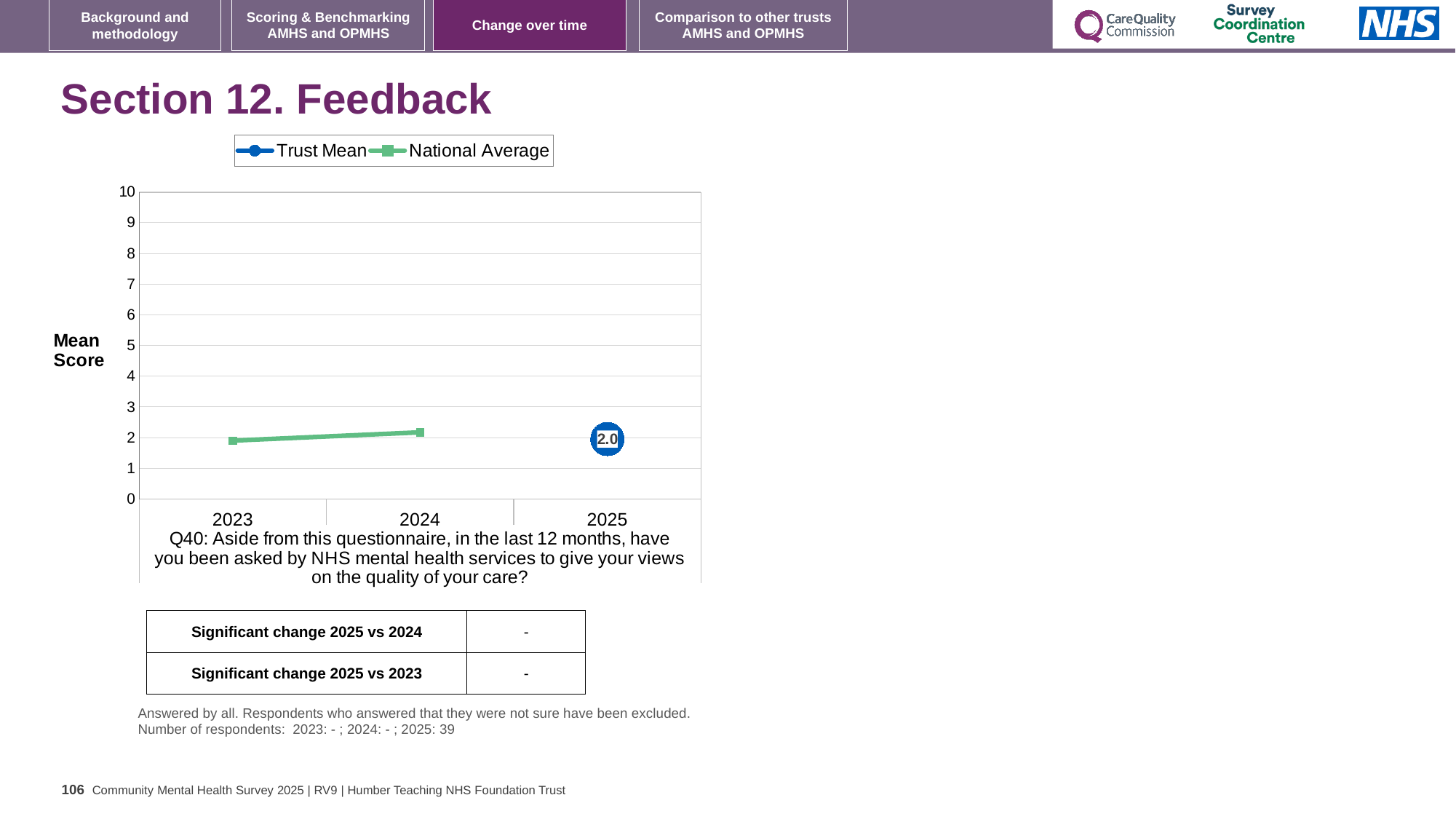
Is the National Average value for 2023 greater or less than 1? greater How many years are shown on the x axis? 3 For which year is a Trust Mean data point plotted? 2025 Does the National Average rise or fall from 2023 to 2024? rise Is the National Average value for 2024 greater or less than 4? less What is the Trust Mean value for 2025? 2.0 How many series does the legend list? 2 Is the Trust Mean value for 2025 greater or less than 5? less What are the two series named in the legend? Trust Mean and National Average What is the label on the y axis? Mean Score What kind of chart is shown on the slide? line chart